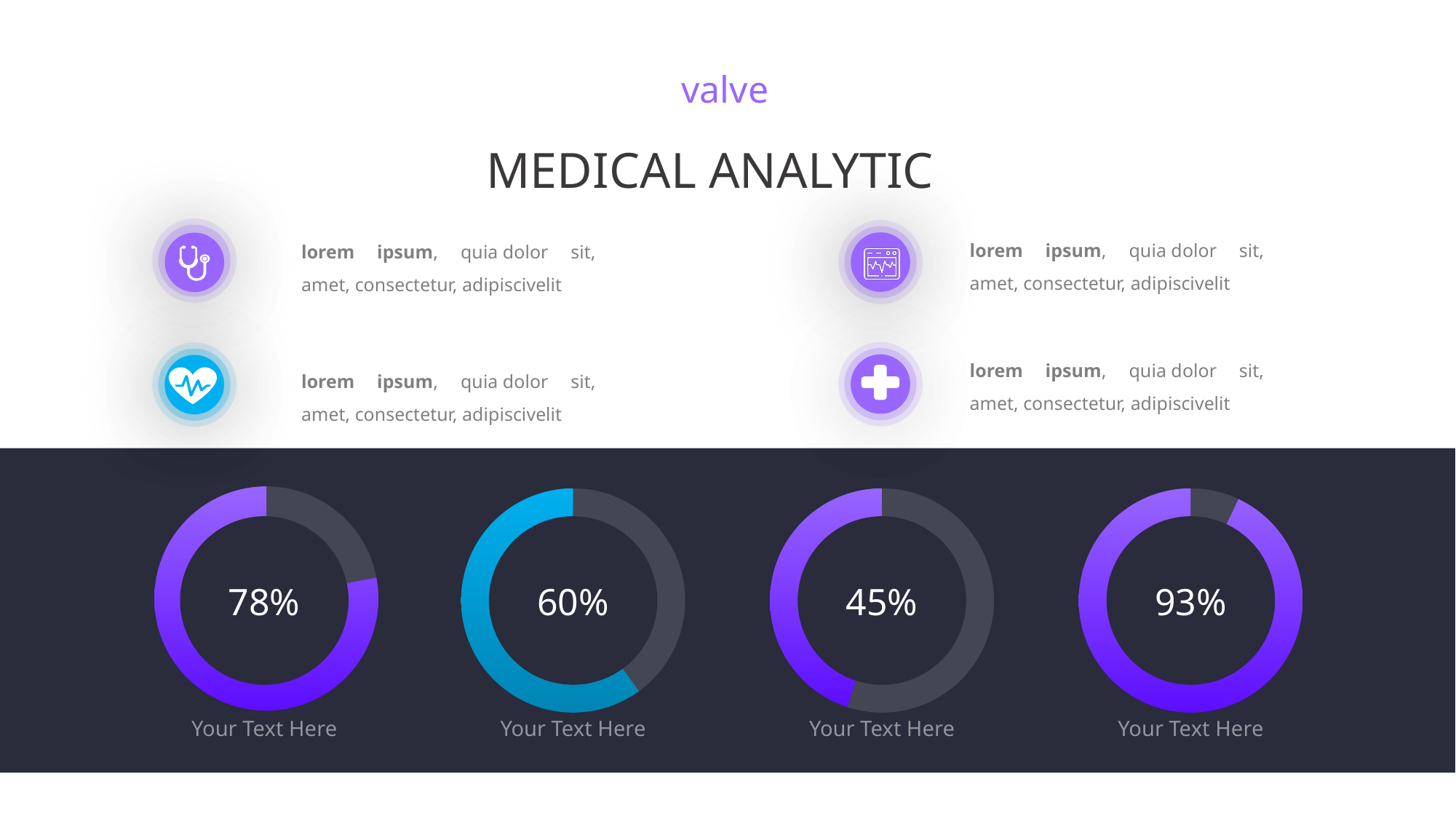
What value is shown in the leftmost donut chart? 78% What is the difference between the second donut chart's value and the third donut chart's value? 15% How many donut charts are shown on the slide? 4 Which is larger, the value in the leftmost donut chart or the value in the second donut chart from the left? The leftmost (78%) What value is shown in the second donut chart from the left? 60% Which donut chart shows the lowest percentage? The third from the left (45%) Which donut chart uses a blue filled ring instead of purple? The second from the left (60%) What value is shown in the third donut chart from the left? 45% What kind of chart is used in the dark band at the bottom of the slide? Donut chart Which donut chart shows the highest percentage? The rightmost (93%) What value is shown in the rightmost donut chart? 93% What is the difference between the rightmost donut chart's value and the leftmost donut chart's value? 15%